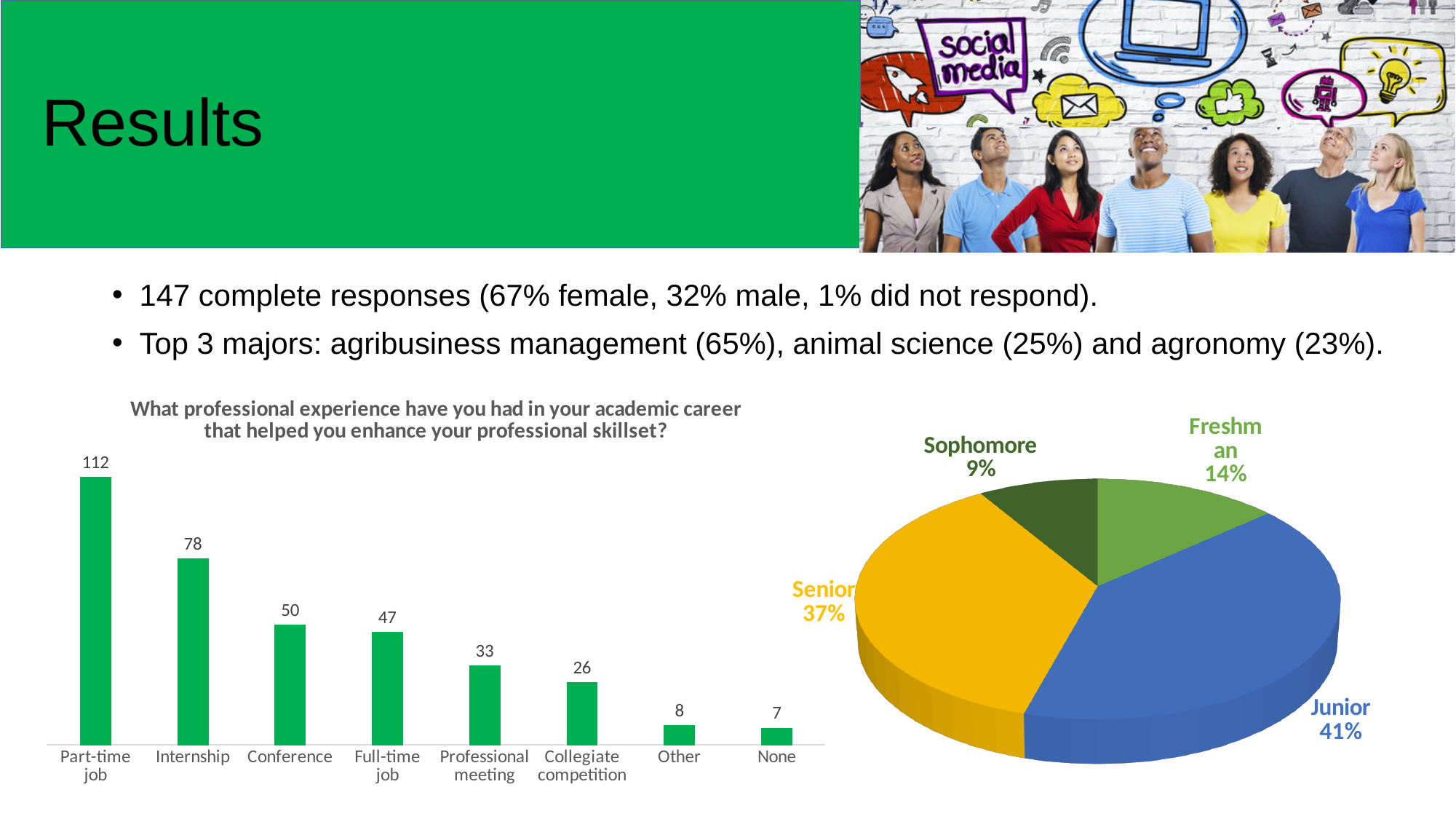
In the bar chart on the left, which category has the lowest value? None How many categories are shown in the bar chart on the left? 8 In the pie chart on the right, what share is Senior? 37% What is the title of the bar chart on the left? What professional experience have you had in your academic career that helped you enhance your professional skillset? In the pie chart on the right, which class year has the largest share? Junior In the bar chart on the left, what is the difference between Part-time job and Internship? 34 In the bar chart on the left, which is larger, Conference or Full-time job? Conference In the bar chart on the left, what is the value for Internship? 78 In the bar chart on the left, which category has the highest value? Part-time job In the bar chart on the left, what is the value for Professional meeting? 33 In the bar chart on the left, do the values rise or fall from left to right? Fall What kind of chart is the chart on the left? Bar chart